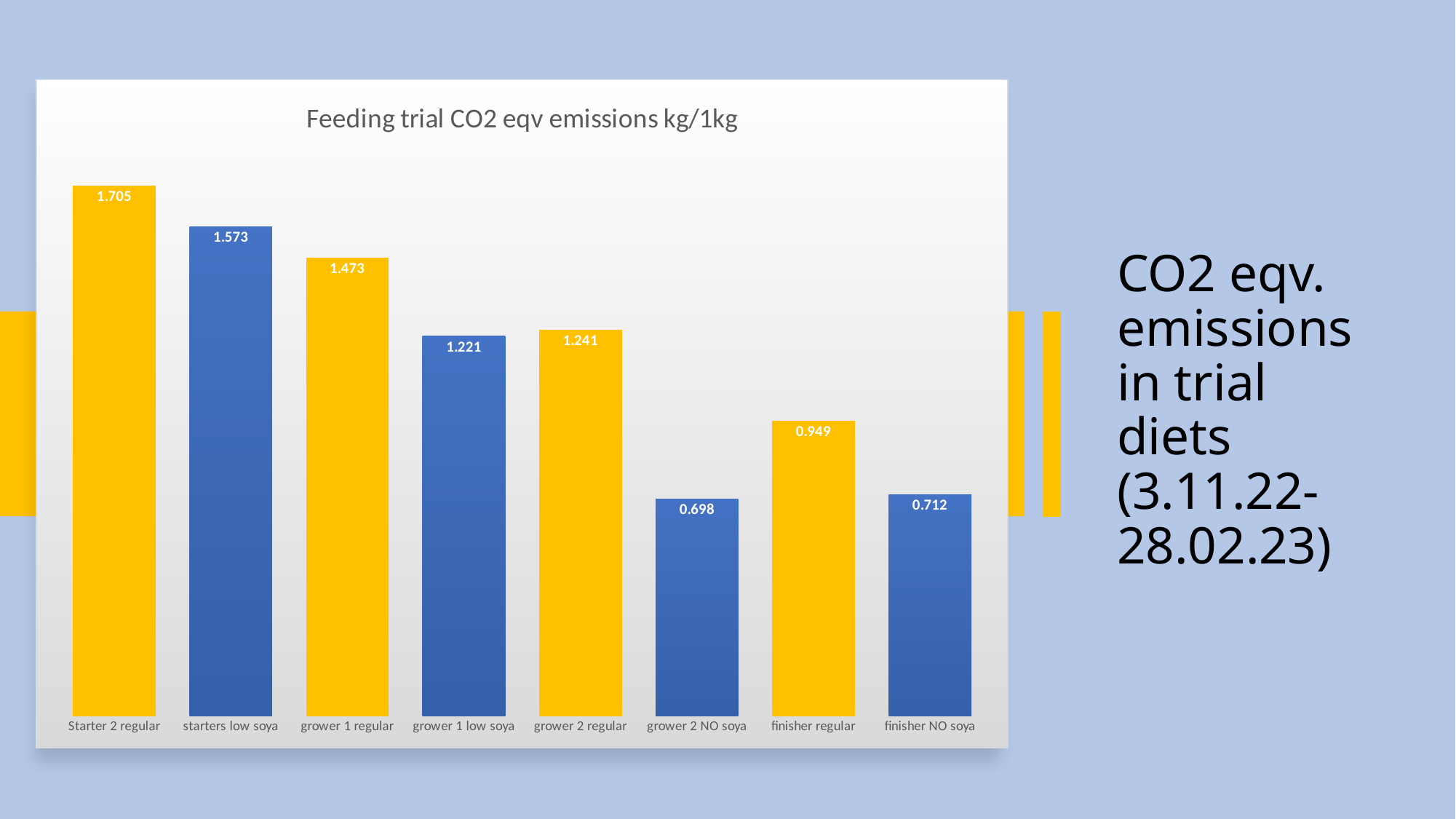
Which is larger, grower 1 regular or finisher regular? grower 1 regular What type of chart is shown on the slide? bar chart Which diet has the highest CO2 eqv emissions? Starter 2 regular What is the CO2 eqv emissions value for Starter 2 regular? 1.705 What is the value shown for grower 2 NO soya? 0.698 What is the difference between Starter 2 regular and starters low soya? 0.132 What is the difference between grower 2 regular and grower 2 NO soya? 0.543 What is the title of the chart? Feeding trial CO2 eqv emissions kg/1kg How many diets are shown in the chart? 8 What is the value shown for grower 1 low soya? 1.221 Which diet has the lowest CO2 eqv emissions? grower 2 NO soya What is the value shown for finisher regular? 0.949